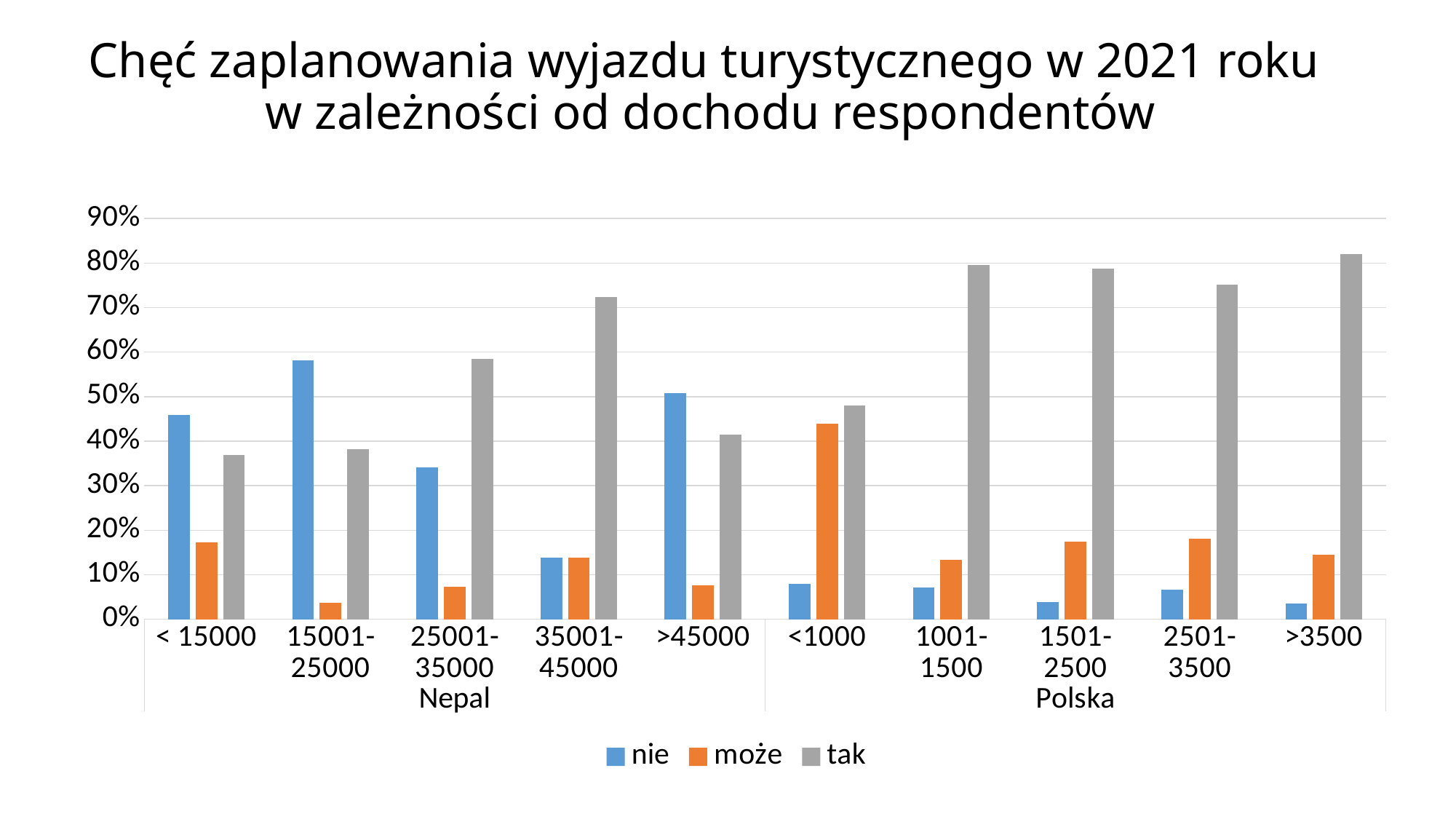
Is the 'nie' value for the < 15000 category greater or less than 40%? greater Is the 'może' value for the 15001-25000 category greater or less than 10%? less For the <1000 category, which is larger: 'nie' or 'może'? może What kind of chart is shown on the slide? bar chart Which two country groups are the income categories divided into? Nepal and Polska How many series does the legend list? 3 What are the three legend entries of the chart? nie, może, tak How many income categories are shown along the x axis? 10 For the 15001-25000 category, which is larger: 'nie' or 'tak'? nie Is the 'tak' value for the 35001-45000 category greater or less than 60%? greater Which income category has the lowest value for the 'może' series? 15001-25000 Which income category has the highest value for the 'nie' series? 15001-25000